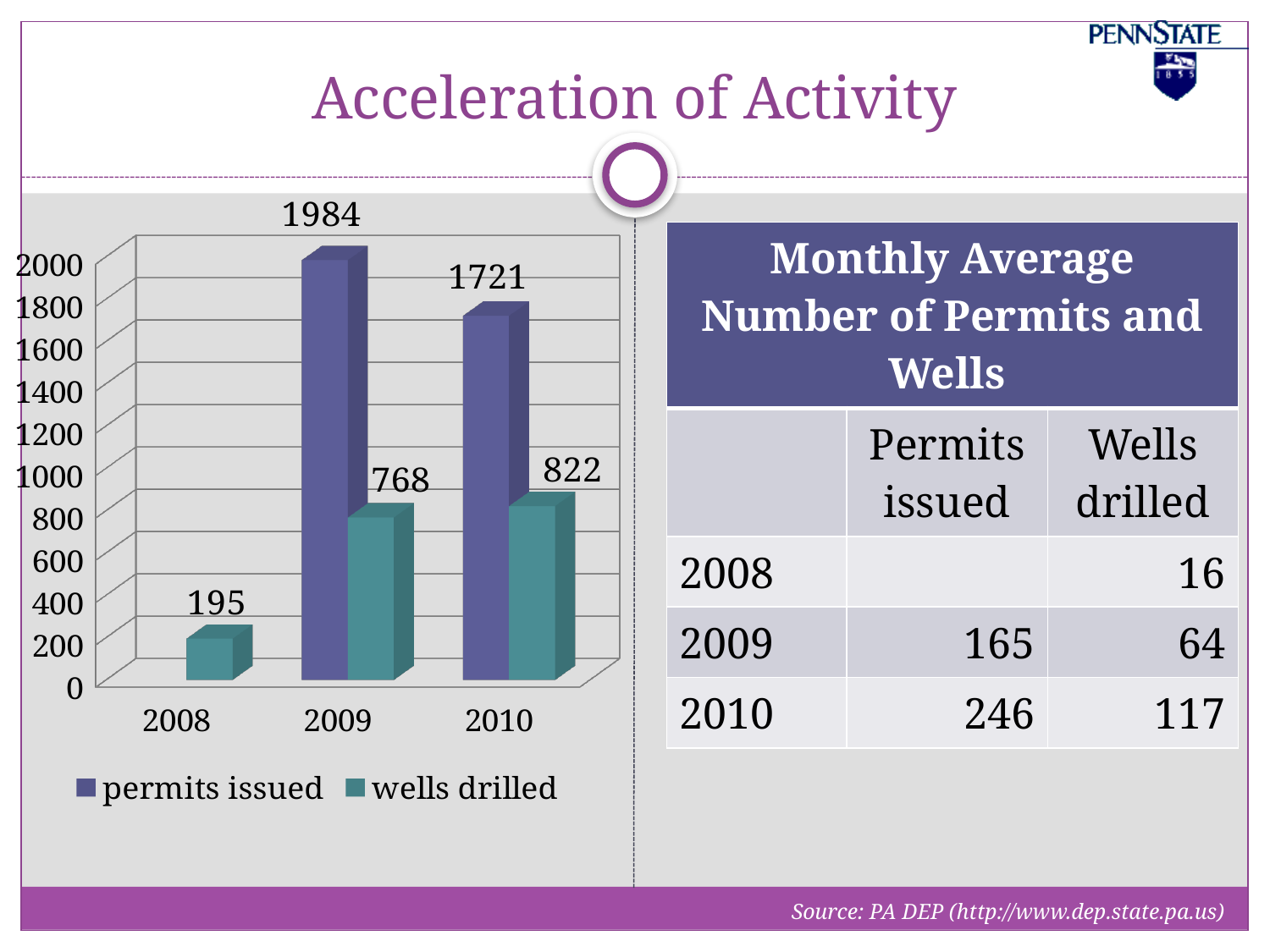
What is the value for wells drilled in 2008? 195 What is the value for wells drilled in 2010? 822 How many years are shown on the x axis of the chart? 3 What kind of chart is shown on the slide? bar chart What is the difference between permits issued in 2009 and permits issued in 2010? 263 Which year has the highest value for permits issued? 2009 Which year has the lowest value for wells drilled? 2008 Do the values for wells drilled rise or fall from 2008 to 2010? rise What is the value for permits issued in 2009? 1984 Which is larger: wells drilled in 2009 or wells drilled in 2010? wells drilled in 2010 What is the value for permits issued in 2010? 1721 How many series does the chart legend list? 2